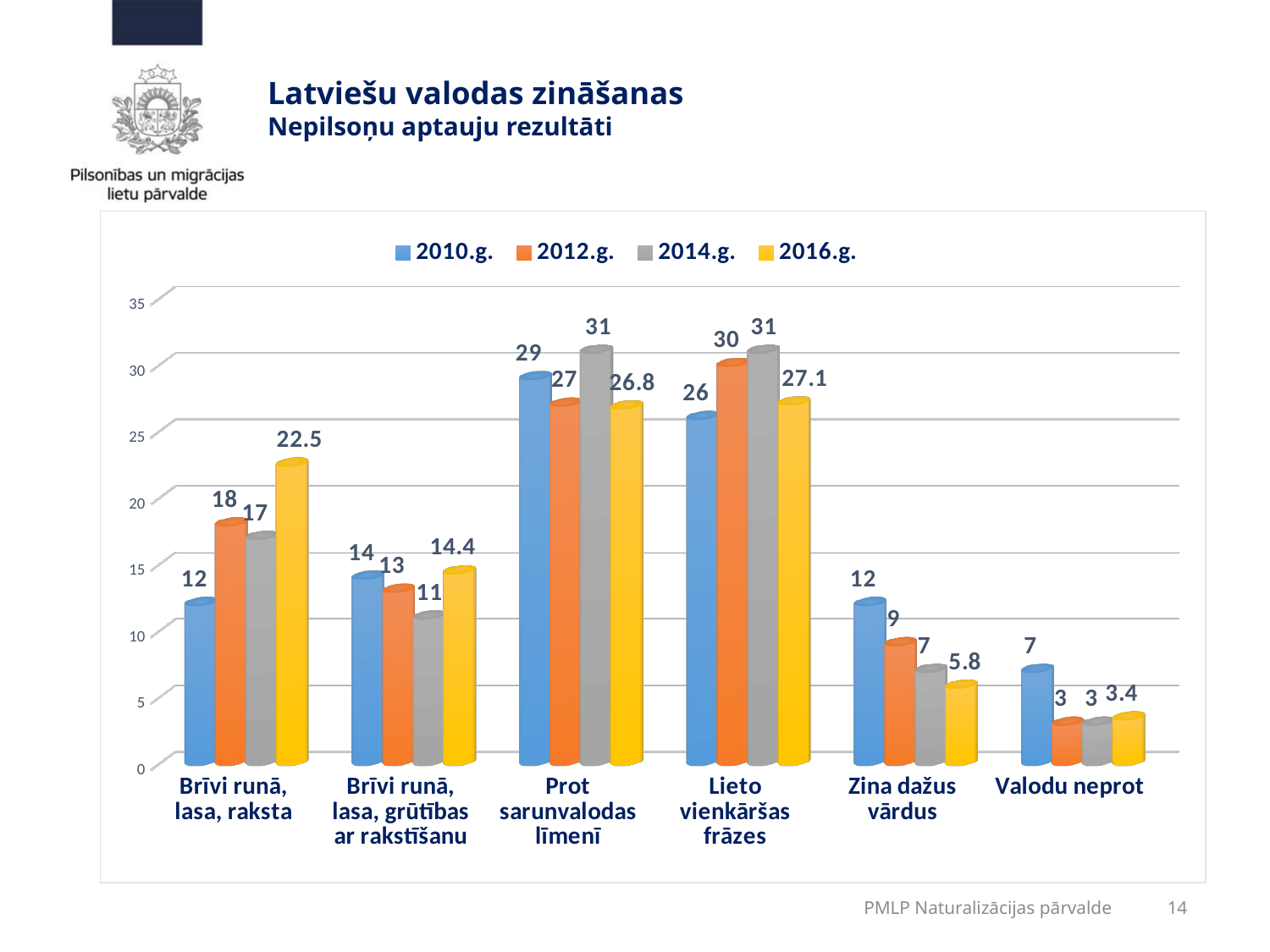
What is the value for 2012.g. in the category "Lieto vienkāršas frāzes"? 30 Which colour represents the 2016.g. series in the chart? Yellow How many categories are shown on the x axis? 6 What is the difference between the 2016.g. and 2010.g. values in the category "Brīvi runā, lasa, raksta"? 10.5 What is the value for 2016.g. in the category "Brīvi runā, lasa, raksta"? 22.5 What kind of chart is shown on the slide? Bar chart What is the value for 2014.g. in the category "Prot sarunvalodas līmenī"? 31 How many series does the legend list? 4 Which category has the lowest value for 2016.g.? Valodu neprot In the category "Zina dažus vārdus", which is larger: the value for 2010.g. or the value for 2016.g.? 2010.g. Which category has the highest value for 2010.g.? Prot sarunvalodas līmenī What is the value for 2010.g. in the category "Valodu neprot"? 7